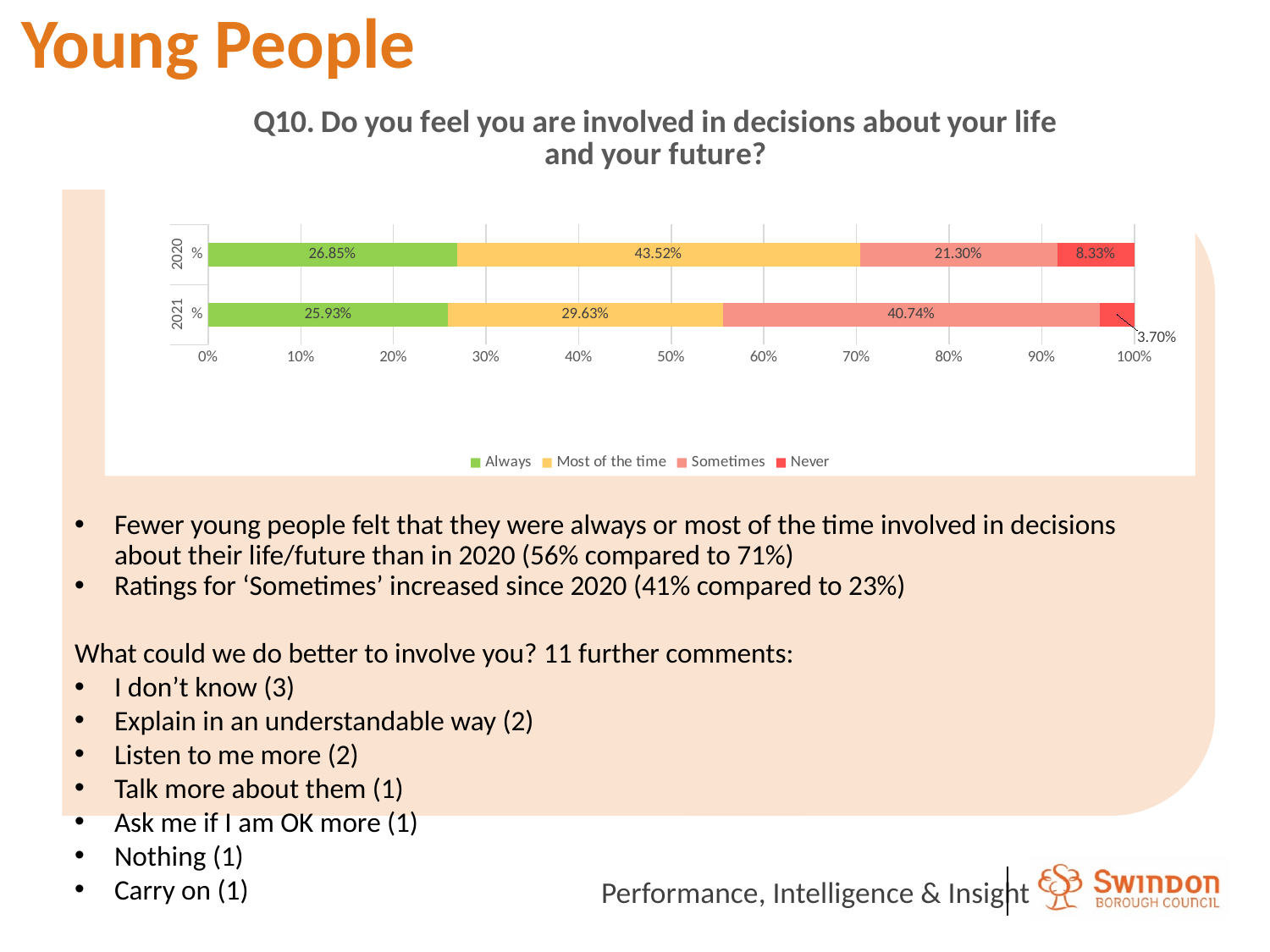
What type of chart is shown on the slide? Stacked bar chart What is the value for 'Most of the time' in 2020? 43.52% How many years (categories) are shown in the chart? 2 Which response had the smallest share in 2021? Never What is the value for 'Never' in 2021? 3.70% Which year had the larger share for 'Most of the time', 2020 or 2021? 2020 By how many percentage points did the 'Sometimes' share change from 2020 to 2021? 19.44 How many series does the legend list? 4 Which response had the largest share in 2020? Most of the time What percentage of young people answered 'Sometimes' in 2021? 40.74% What percentage of young people answered 'Always' in 2020? 26.85% What colour represents the 'Never' response in the chart? Red